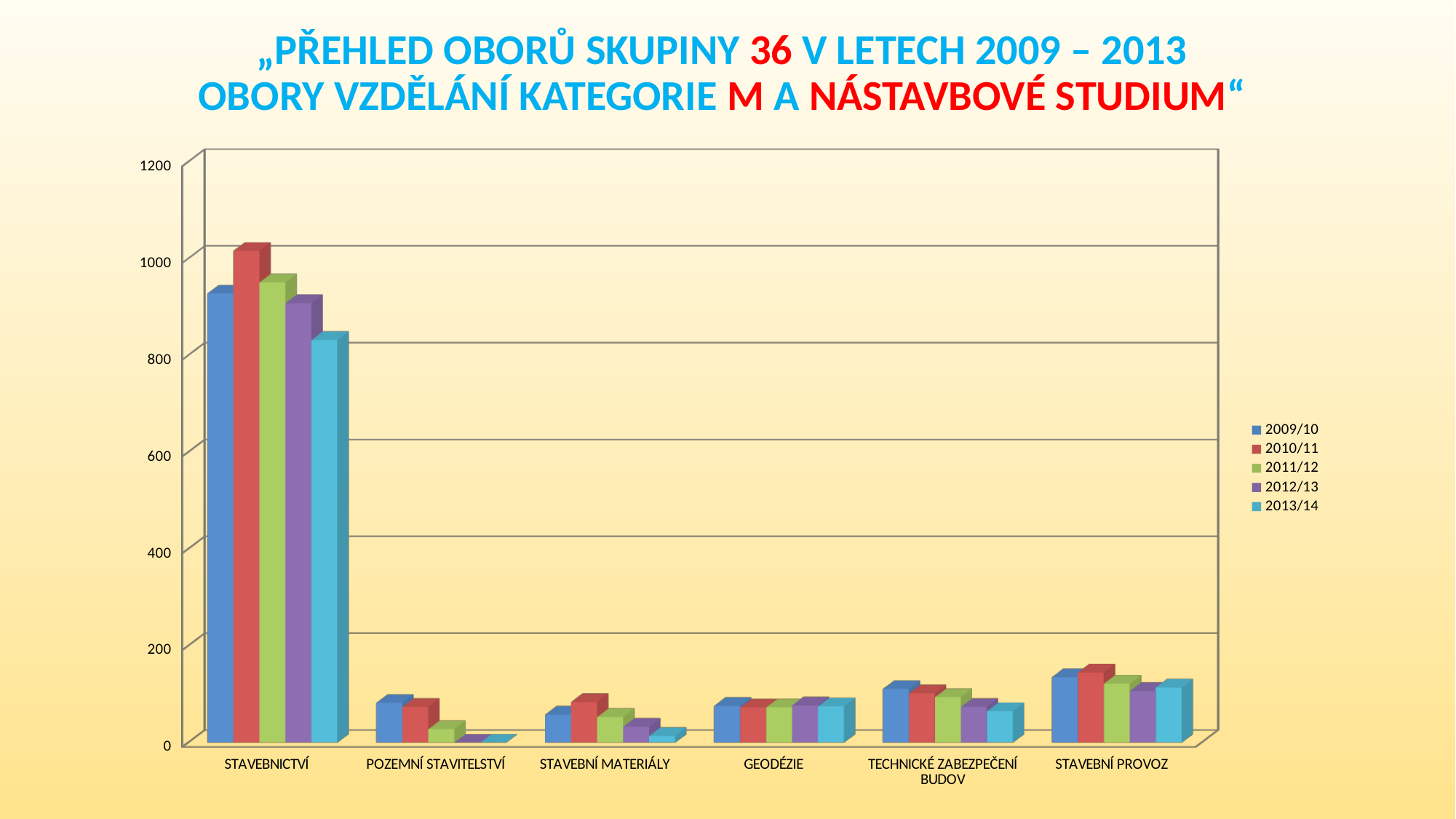
Which category has the highest values in the chart? STAVEBNICTVÍ Is the value for STAVEBNICTVÍ in 2013/14 greater or less than 1000? less How many categories are shown on the x axis of the chart? 6 Is the value for STAVEBNÍ PROVOZ in 2010/11 greater or less than 200? less How many series does the legend list? 5 What kind of chart is shown on the slide? bar chart Which category has the lowest bar for the 2013/14 series? POZEMNÍ STAVITELSTVÍ Do the values for POZEMNÍ STAVITELSTVÍ rise or fall from 2009/10 to 2013/14? fall Which series is listed first in the legend? 2009/10 Within the STAVEBNICTVÍ category, which series has the tallest bar? 2010/11 For STAVEBNICTVÍ, which is larger: the 2009/10 value or the 2013/14 value? 2009/10 Is the value for STAVEBNICTVÍ in 2009/10 greater or less than 800? greater